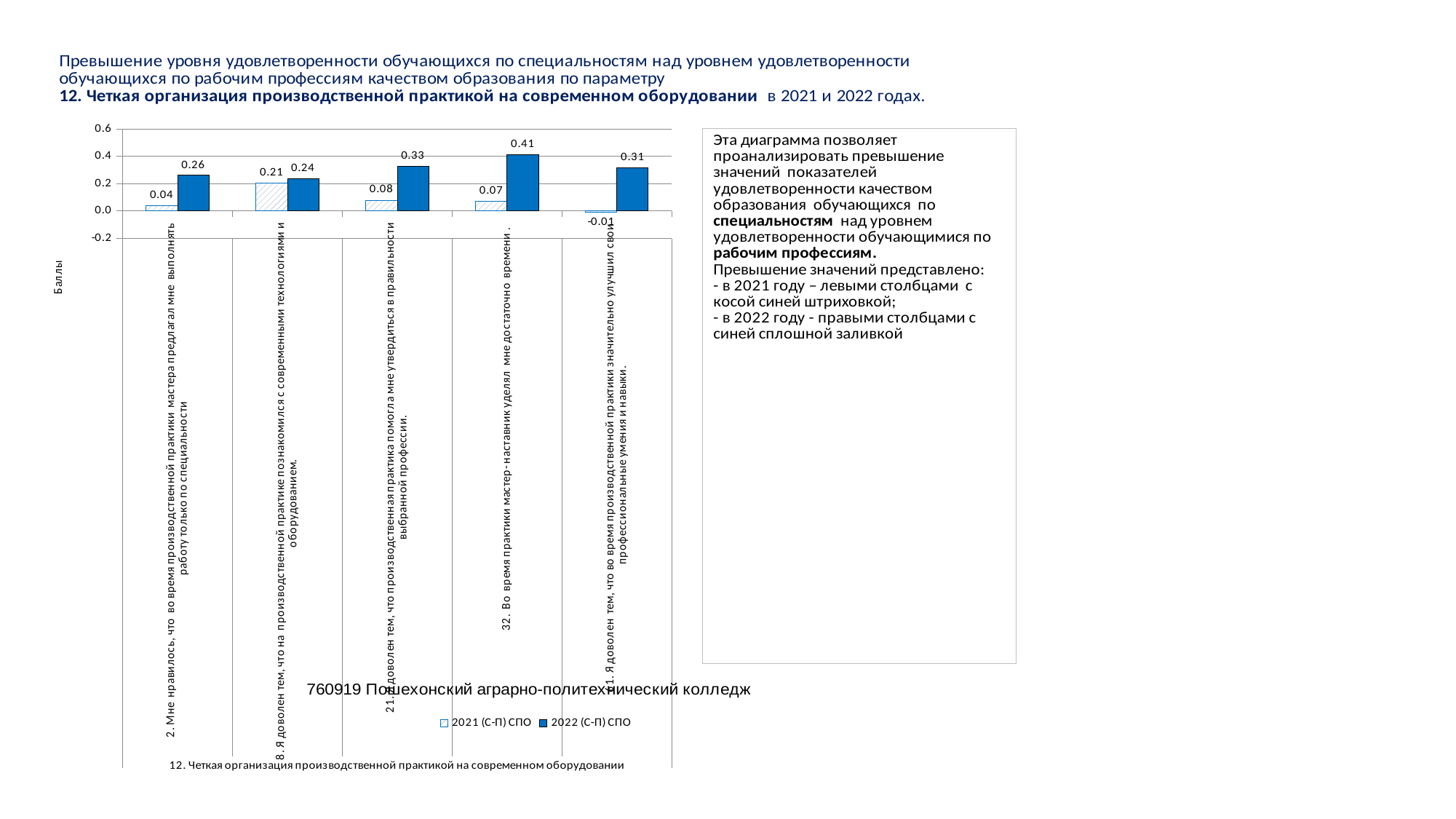
What type of chart is shown on the slide? bar chart What are the two legend entries of the chart? 2021 (С-П) СПО and 2022 (С-П) СПО What is the label of the vertical axis? Баллы Which statement has the highest 2022 (С-П) СПО value? 32. Во время практики мастер-наставник уделял мне достаточно времени What is the 2022 (С-П) СПО value for statement 32 (the master-mentor devoted enough time to me)? 0.41 What is the difference between the 2022 and 2021 values for statement 2 (the master offered me work only in my specialty)? 0.22 Which statement has the lowest 2021 (С-П) СПО value? 61. Я доволен тем, что во время производственной практики значительно улучшил свои профессиональные умения и навыки. How many categories (survey statements) are plotted on the x axis? 5 For statement 21 (practice helped me confirm the correctness of my chosen profession), which series has the larger value, 2021 or 2022? 2022 (С-П) СПО How many series does the legend list? 2 What is the 2021 (С-П) СПО value for statement 8 (got acquainted with modern technologies and equipment)? 0.21